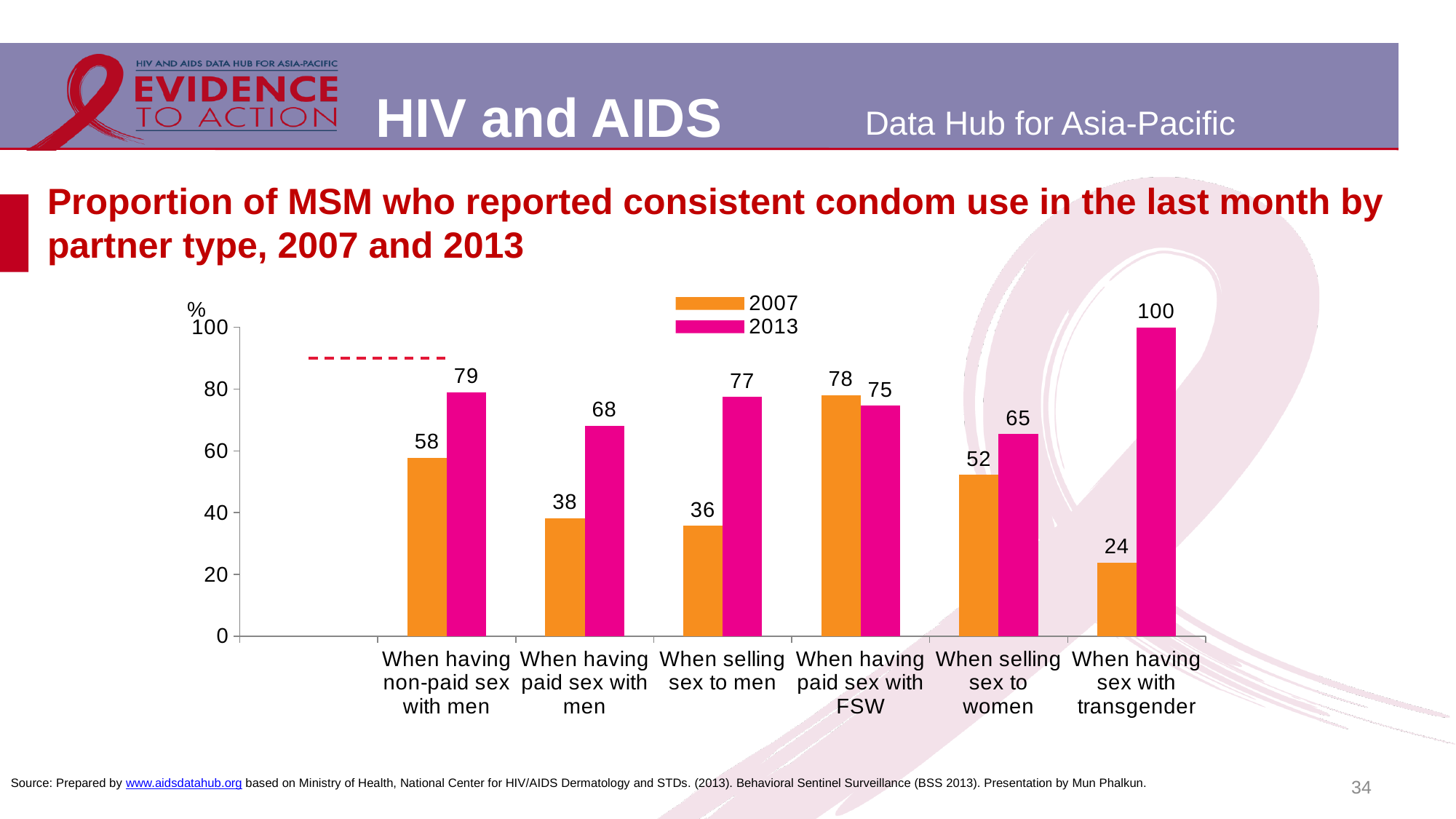
What is the 2007 value for when selling sex to women? 52 How many partner type categories are shown on the x axis? 6 What is the difference between the 2013 and 2007 values for when having paid sex with men? 30 What was the proportion of MSM reporting consistent condom use when having non-paid sex with men in 2013? 79 Which partner type had the highest 2013 value? When having sex with transgender How many series does the legend list? 2 What was the 2007 value for consistent condom use when selling sex to men? 36 What was the 2013 value for consistent condom use when having sex with transgender? 100 What kind of chart is shown on the slide? Bar chart Which is larger for when having paid sex with FSW: the 2007 value or the 2013 value? 2007 Which partner type had the lowest 2007 value? When having sex with transgender Which colour represents the 2013 series in the legend? Pink (magenta)